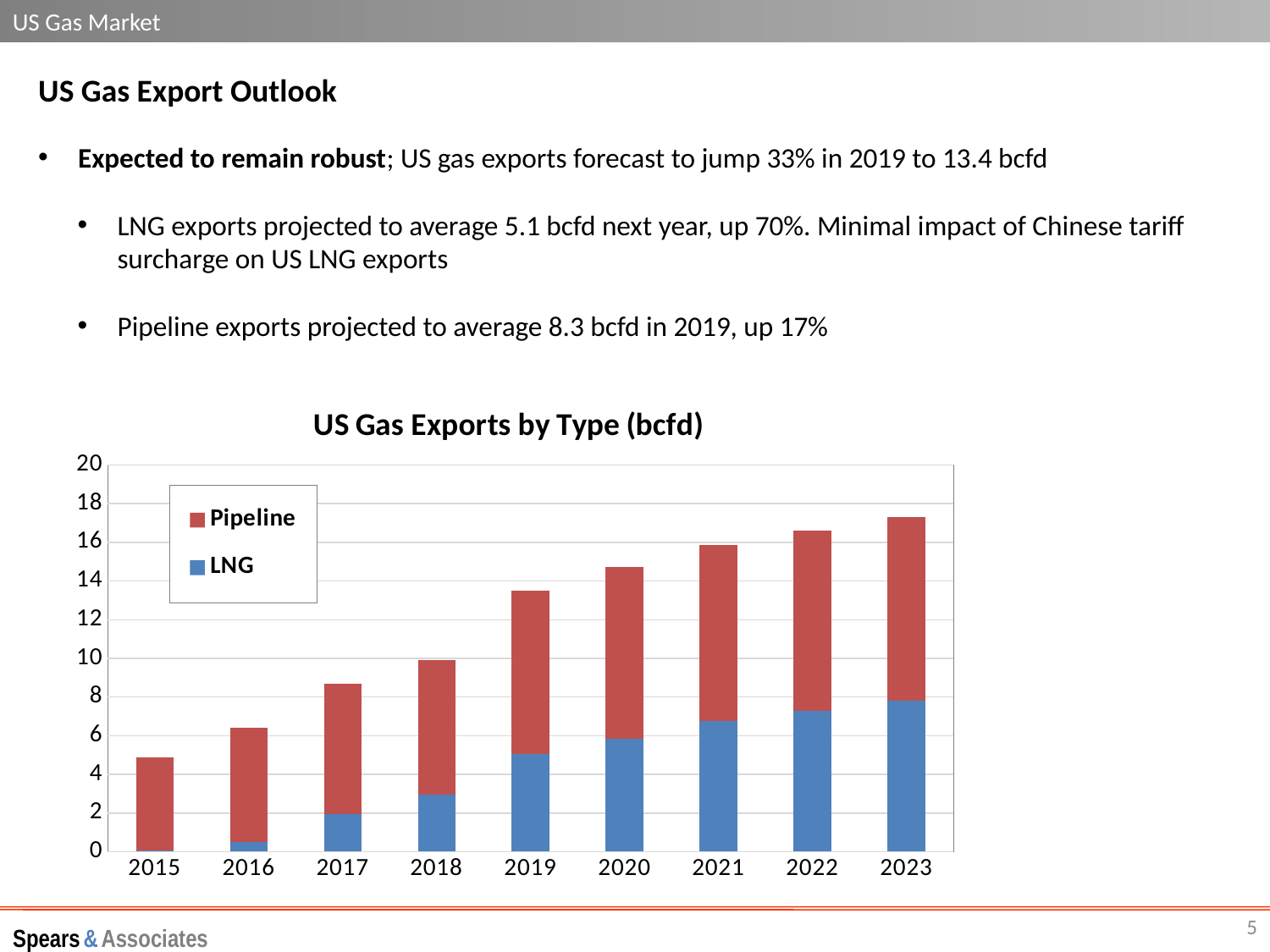
What type of chart is shown on the slide? Stacked bar chart Do total US gas exports rise or fall from 2015 to 2023 in the chart? Rise Which year has the highest total gas exports in the chart? 2023 How many series does the chart's legend list? 2 How many years are shown on the x axis of the chart? 9 What is the title of the chart? US Gas Exports by Type (bcfd) Which year has the lowest total gas exports in the chart? 2015 Is the total bar for 2023 greater or less than 16? greater Is the total bar for 2015 greater or less than 6? less Which year has the larger total gas exports, 2017 or 2019? 2019 Which two series are listed in the chart's legend? Pipeline and LNG Is the LNG value for 2018 greater or less than 4? less